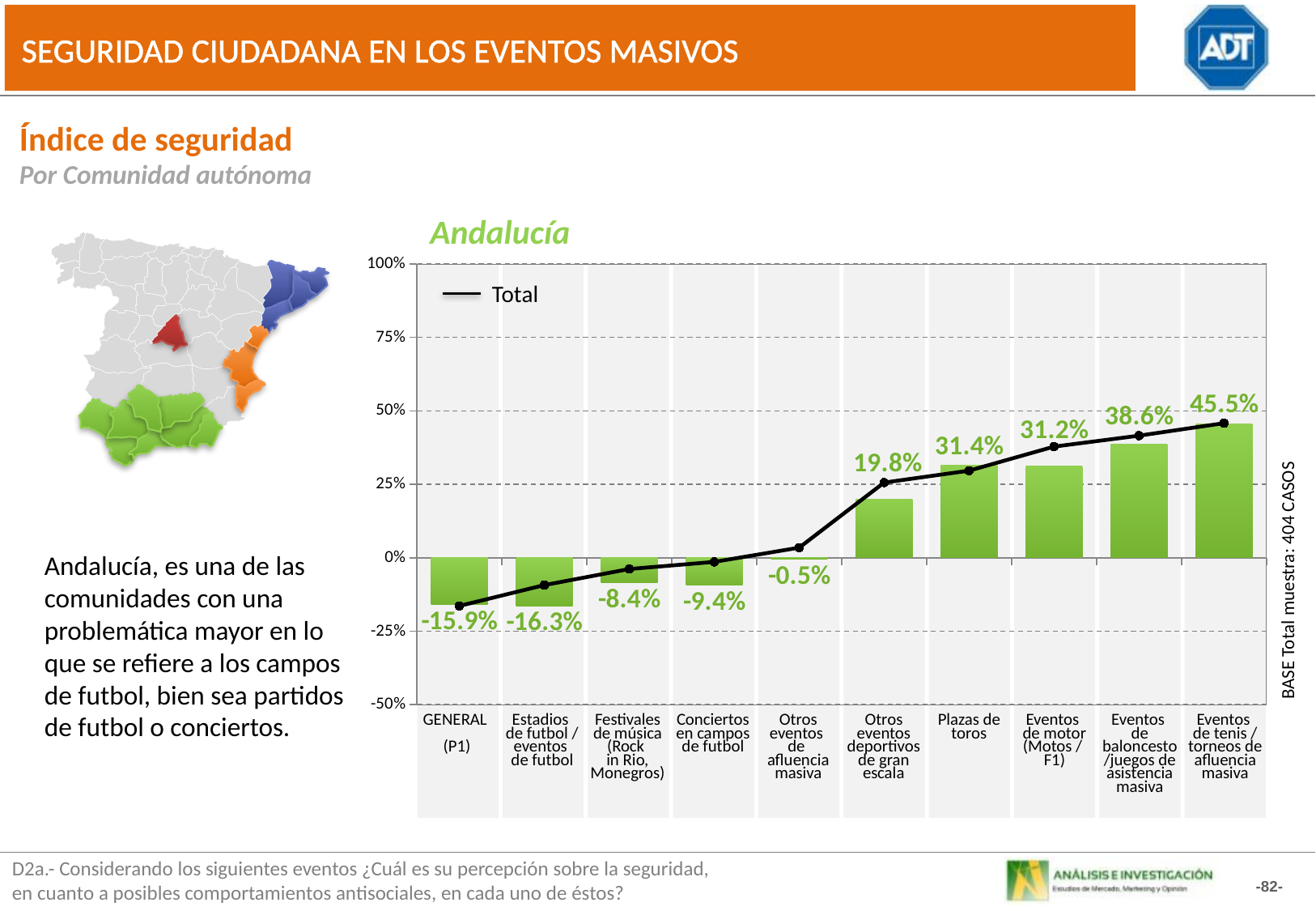
Do the bar values generally rise or fall from left to right across the x axis? Rise Is the Total line value for GENERAL (P1) greater or less than 0%? less What kind of chart is shown on the slide? Bar chart with a line What is the value for Otros eventos deportivos de gran escala? 19.8% Which category has the highest value in the Andalucía chart? Eventos de tenis / torneos de afluencia masiva Which is larger, the value for Festivales de música or the value for Conciertos en campos de futbol? Festivales de música Is the Total line value for Eventos de tenis / torneos de afluencia masiva greater or less than 50%? less Which category has the lowest value in the Andalucía chart? Estadios de futbol / eventos de futbol What is the value for GENERAL (P1) in the Andalucía chart? -15.9% What is the value for Eventos de tenis / torneos de afluencia masiva in the Andalucía chart? 45.5% What is the difference between the values for Eventos de tenis / torneos de afluencia masiva and Eventos de baloncesto / juegos de asistencia masiva? 6.9 percentage points How many categories are shown on the x axis of the chart? 10